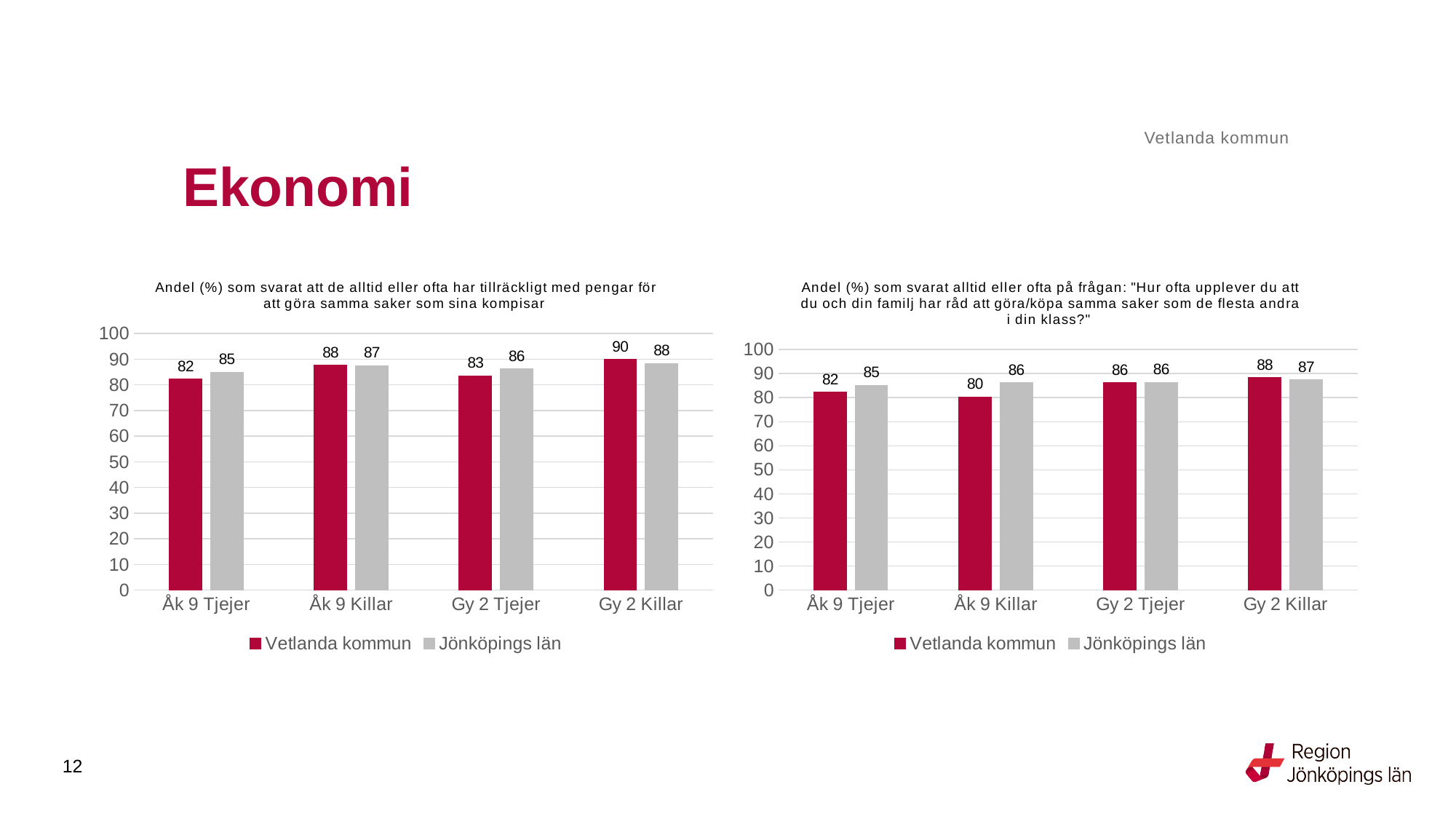
In the right chart, what is the value for Jönköpings län for Gy 2 Killar? 87 In the left chart, what is the difference between Jönköpings län and Vetlanda kommun for Gy 2 Tjejer? 3 In the left chart, what is the value for Jönköpings län for Gy 2 Killar? 88 How many categories are shown on the x axis of the left chart? 4 In the left chart, which category has the highest value for Vetlanda kommun? Gy 2 Killar In the left chart, which category has the lowest value for Vetlanda kommun? Åk 9 Tjejer In the right chart, which is larger for Gy 2 Killar: Vetlanda kommun or Jönköpings län? Vetlanda kommun How many series does the legend of the right chart list? 2 In the left chart, what is the value for Vetlanda kommun for Åk 9 Tjejer? 82 In the right chart, what is the value for Vetlanda kommun for Åk 9 Killar? 80 In the right chart, which category has the lowest value for Vetlanda kommun? Åk 9 Killar In the right chart, what is the difference between Jönköpings län and Vetlanda kommun for Åk 9 Killar? 6